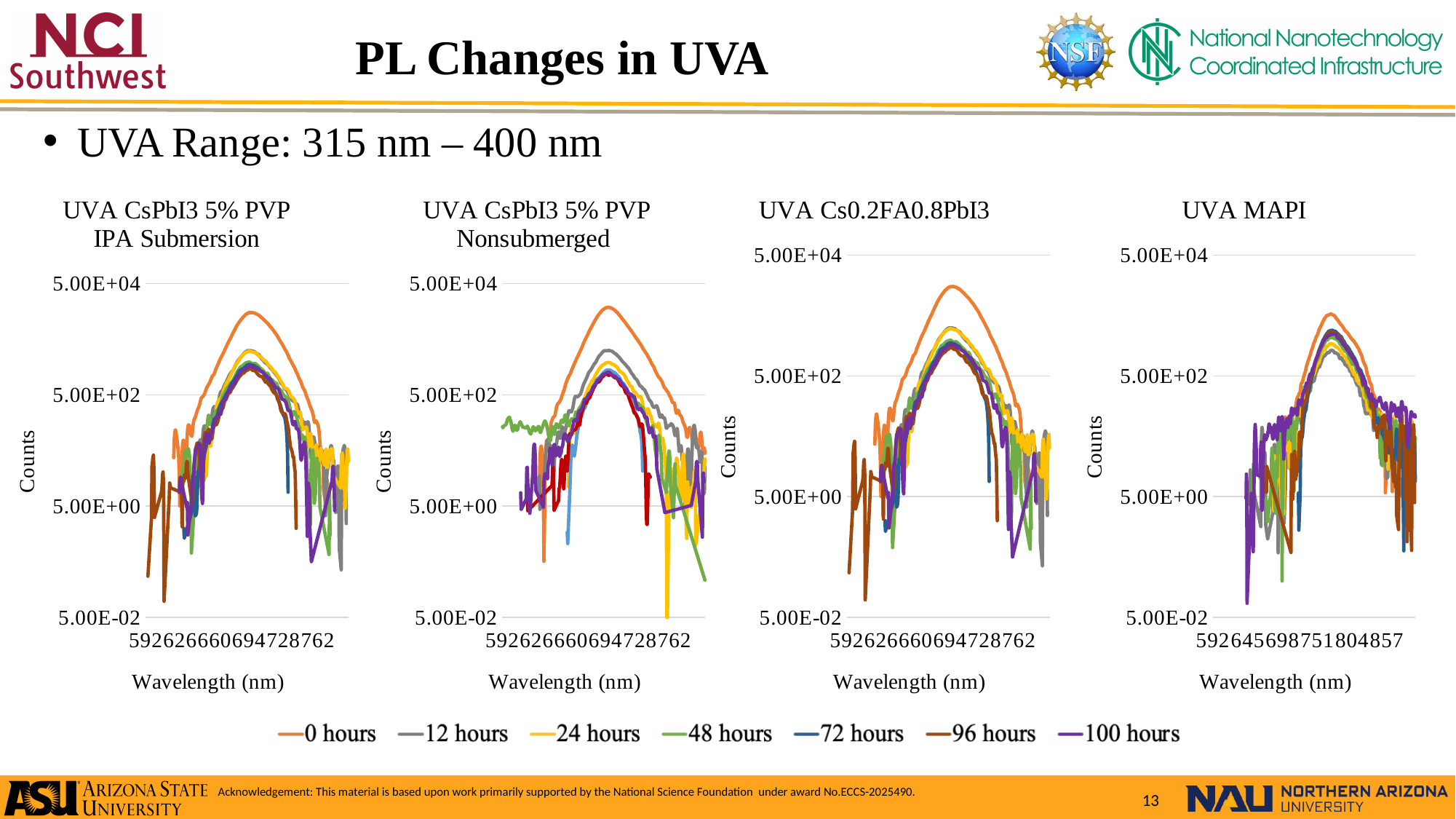
In the 'UVA Cs0.2FA0.8PbI3' chart, which series reaches the highest peak? 0 hours In the 'UVA CsPbI3 5% PVP IPA Submersion' chart, which series has the higher peak, 0 hours or 24 hours? 0 hours In the 'UVA CsPbI3 5% PVP IPA Submersion' chart, is the peak of the 0 hours series greater or less than 5.00E+02? greater What kind of chart is the 'UVA CsPbI3 5% PVP IPA Submersion' chart? line chart In the 'UVA MAPI' chart, is the peak of the 12 hours series greater or less than 5.00E+02? greater In the 'UVA CsPbI3 5% PVP Nonsubmerged' chart, which series reaches the highest peak? 0 hours In the 'UVA CsPbI3 5% PVP Nonsubmerged' chart, which series has the higher peak, 0 hours or 12 hours? 0 hours What is the label on the y axis of the charts? Counts How many charts are shown on the slide? 4 What is the title of the rightmost chart? UVA MAPI How many series does the shared legend list? 7 In the 'UVA Cs0.2FA0.8PbI3' chart, is the peak of the 0 hours series greater or less than 5.00E+04? less